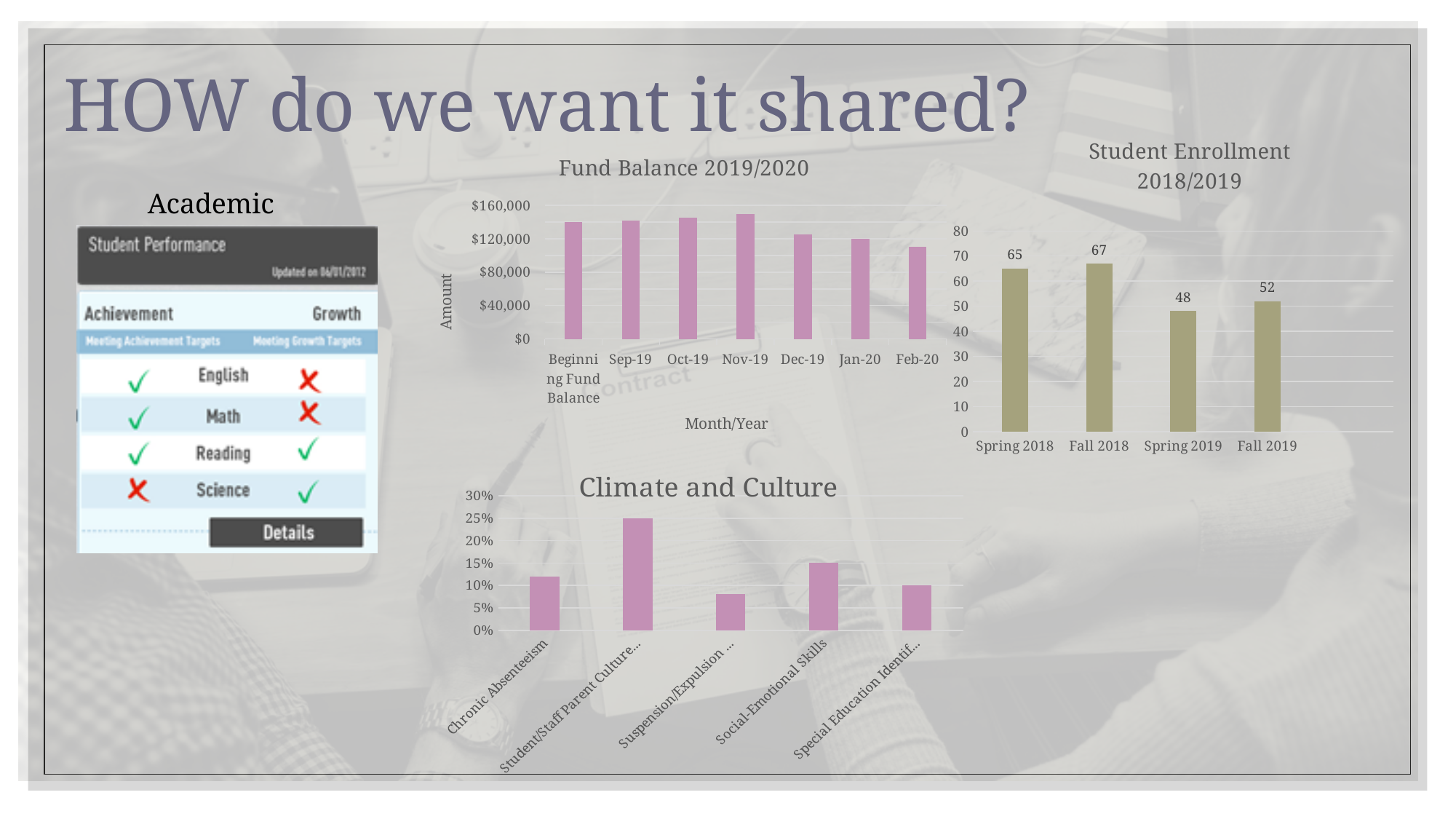
In the Fund Balance 2019/2020 chart, which month has the lowest fund balance? Feb-20 In the Student Enrollment 2018/2019 chart, what is the value for Spring 2018? 65 In the Fund Balance 2019/2020 chart, is the value for Feb-20 greater or less than $120,000? less In the Student Enrollment 2018/2019 chart, which is larger, Fall 2019 or Spring 2019? Fall 2019 In the Student Enrollment 2018/2019 chart, which category has the highest value? Fall 2018 In the Student Enrollment 2018/2019 chart, what is the difference between Fall 2018 and Spring 2019? 19 How many categories are shown in the Climate and Culture chart? 5 In the Student Enrollment 2018/2019 chart, which category has the lowest value? Spring 2019 In the Student Enrollment 2018/2019 chart, what is the value for Spring 2019? 48 What kind of chart is the Fund Balance 2019/2020 chart? Bar chart In the Climate and Culture chart, is the value for Chronic Absenteeism greater or less than 10%? greater In the Fund Balance 2019/2020 chart, which month has the highest fund balance? Nov-19